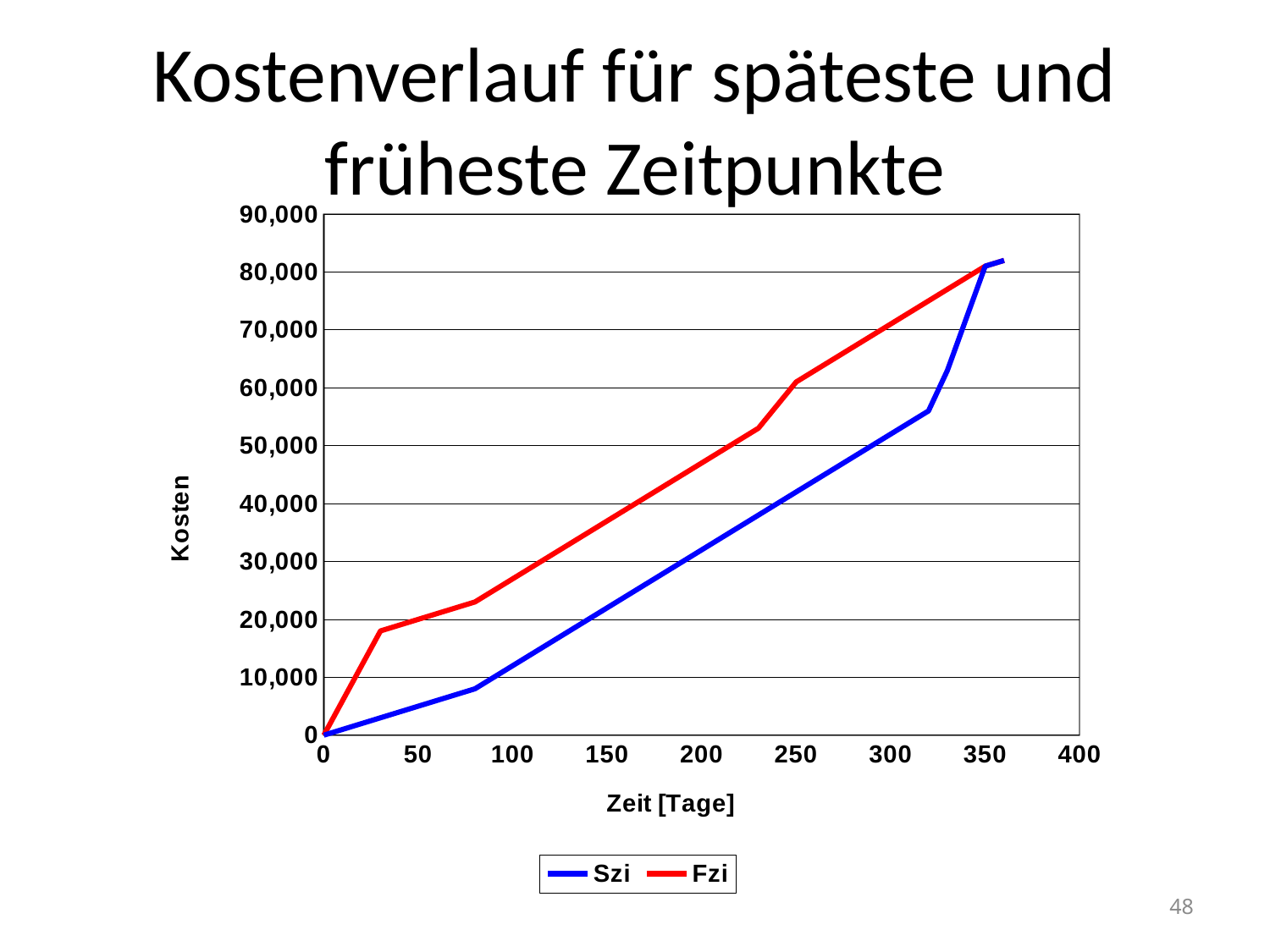
Is the value of Fzi at 250 days greater or less than 50,000? greater Is the value of Szi at 250 days greater or less than 50,000? less At 200 days, which series has the higher cost, Szi or Fzi? Fzi What is the value of Szi at 0 days? 0 What is the title of the x axis? Zeit [Tage] Is the value of Szi at 100 days greater or less than 20,000? less What kind of chart is shown on the slide? line chart How many series does the legend list? 2 What are the names of the two series in the legend? Szi and Fzi Do the Szi values rise or fall as time increases along the x axis? rise